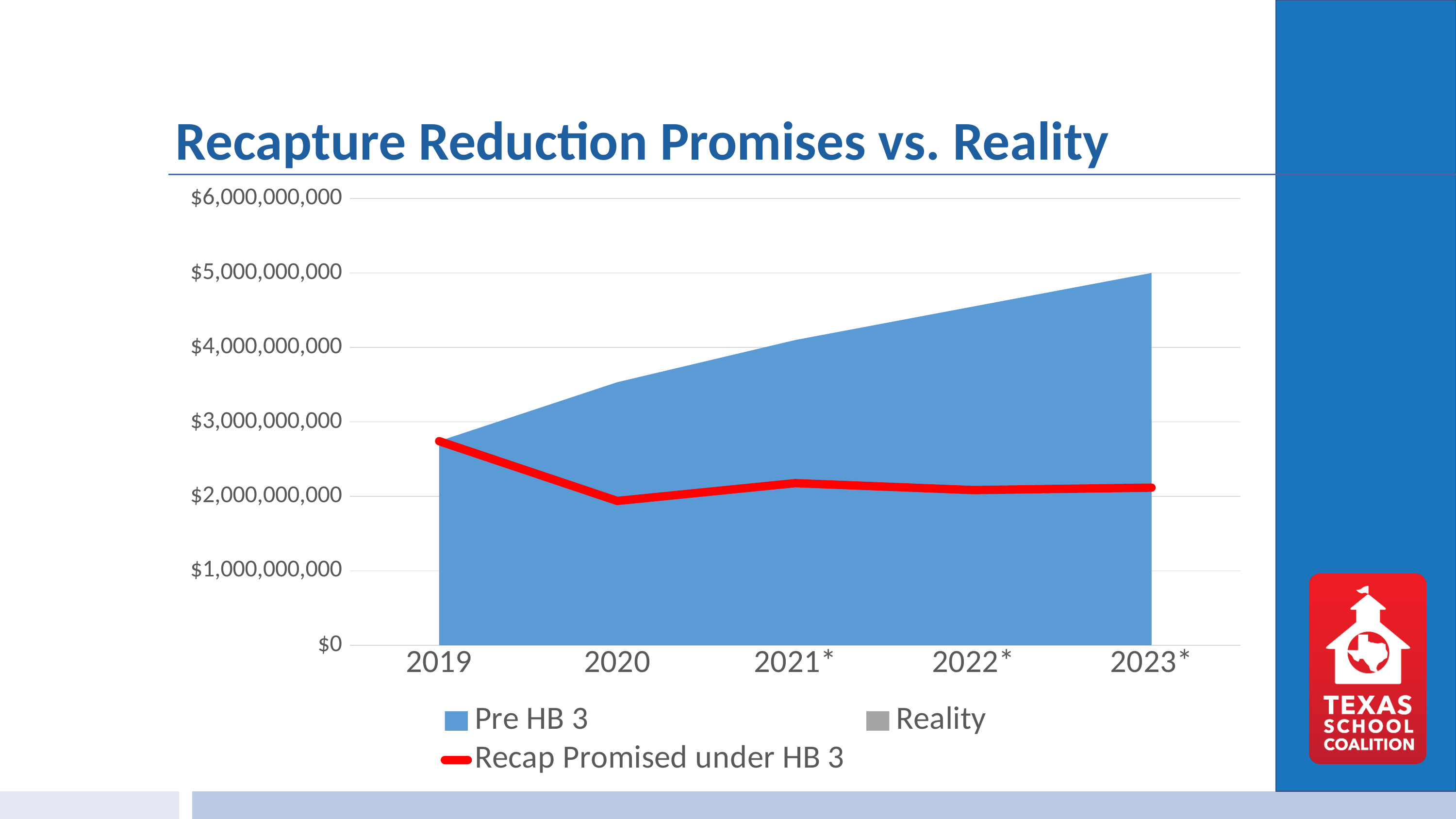
What kind of chart is this? Area chart with a line In 2023*, which is larger: the Pre HB 3 value or the Recap Promised under HB 3 value? Pre HB 3 In which year is the Pre HB 3 value lowest? 2019 Is the Pre HB 3 value for 2022* greater or less than $4,000,000,000? greater Is the Recap Promised under HB 3 value for 2019 greater or less than $2,000,000,000? greater How many series does the legend list? 3 Does the Pre HB 3 series rise or fall from 2019 to 2023*? Rise In which year is the Pre HB 3 value highest? 2023* How many years are shown on the x axis? 5 In which year is the Recap Promised under HB 3 value lowest? 2020 What is the title of the chart? Recapture Reduction Promises vs. Reality